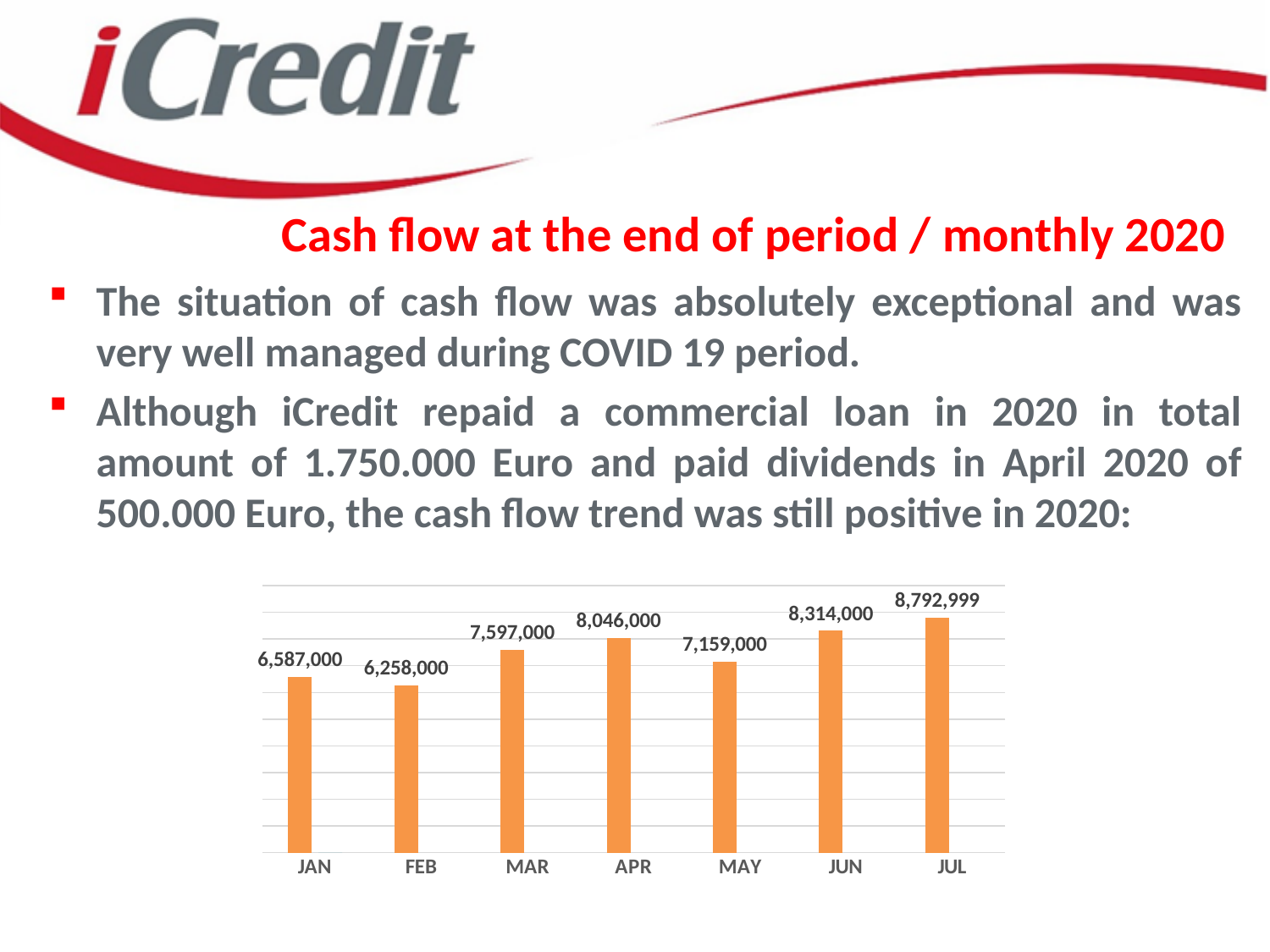
Which is larger, the value for JAN or the value for FEB? JAN What is the difference between the values for JUN and MAY? 1,155,000 Which month has the highest value? JUL How many months are shown on the x axis? 7 Do the values rise or fall from MAY to JUL? Rise Which month has the lowest value? FEB What is the value for MAR? 7,597,000 Which is larger, the value for APR or the value for MAY? APR What is the value for JUL? 8,792,999 What is the value for FEB? 6,258,000 What kind of chart is shown on the slide? Bar chart What is the difference between the values for JUL and JAN? 2,205,999